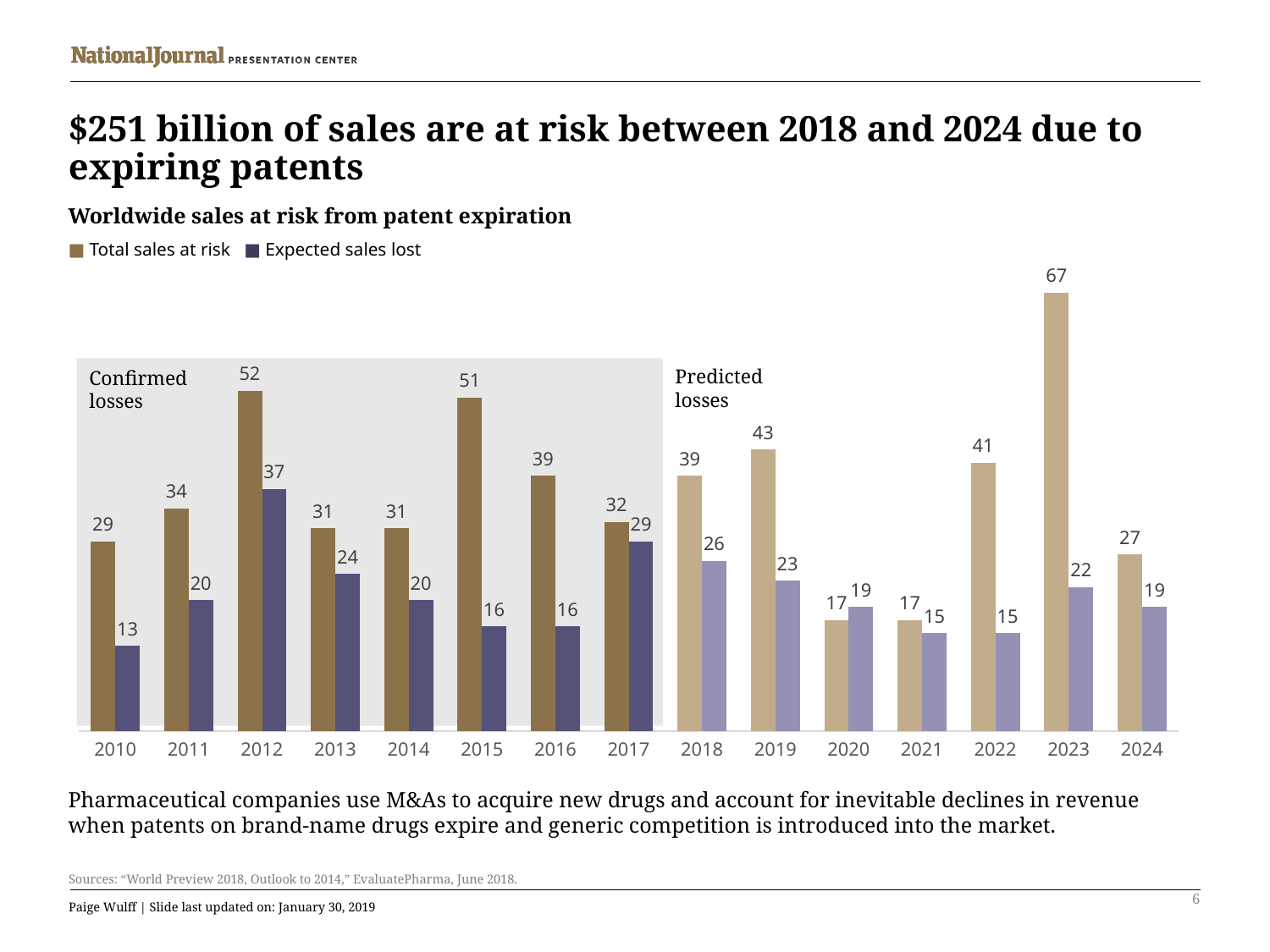
Which year has the highest Total sales at risk? 2023 How many years are shown on the x axis? 15 What is the title of the chart? Worldwide sales at risk from patent expiration What is the difference between Total sales at risk and Expected sales lost in 2015? 35 What is the value of Expected sales lost for 2012? 37 How many series does the legend list? 2 What is the value of Total sales at risk for 2023? 67 Which is larger in 2020: Total sales at risk or Expected sales lost? Expected sales lost What is the difference in Total sales at risk between 2023 and 2024? 40 Which year has the lowest Expected sales lost? 2010 What is the value of Total sales at risk for 2019? 43 What kind of chart is shown on the slide? Bar chart